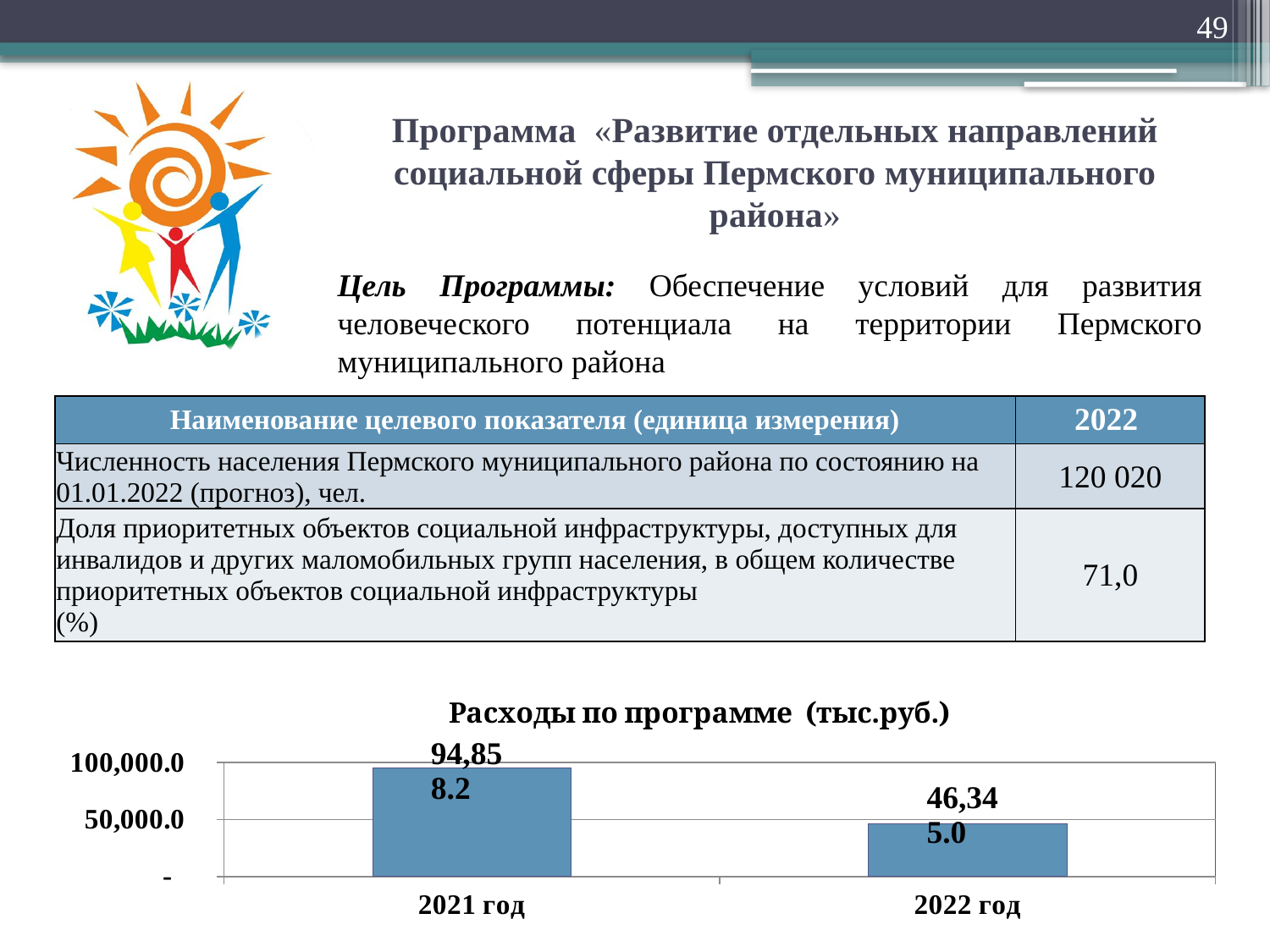
What is the data label shown on the bar for 2021 год in the chart "Расходы по программе (тыс.руб.)"? 94,858.2 What kind of chart is shown under the title "Расходы по программе (тыс.руб.)"? bar chart In the chart "Расходы по программе (тыс.руб.)", is the value for 2022 год greater or less than 50,000.0? less In the chart "Расходы по программе (тыс.руб.)", is the value for 2021 год greater or less than 50,000.0? greater In the chart "Расходы по программе (тыс.руб.)", is the value for 2021 год greater or less than 100,000.0? less How many bars (categories) does the chart "Расходы по программе (тыс.руб.)" show? 2 In the chart "Расходы по программе (тыс.руб.)", is the value for 2021 год larger or smaller than the value for 2022 год? larger In the chart "Расходы по программе (тыс.руб.)", which year has the lower expenditure? 2022 год In the chart "Расходы по программе (тыс.руб.)", do the values rise or fall from 2021 год to 2022 год? fall In the chart "Расходы по программе (тыс.руб.)", which year has the higher expenditure? 2021 год What is the data label shown on the bar for 2022 год in the chart "Расходы по программе (тыс.руб.)"? 46,345.0 What is the title of the chart at the bottom of the slide? Расходы по программе (тыс.руб.)